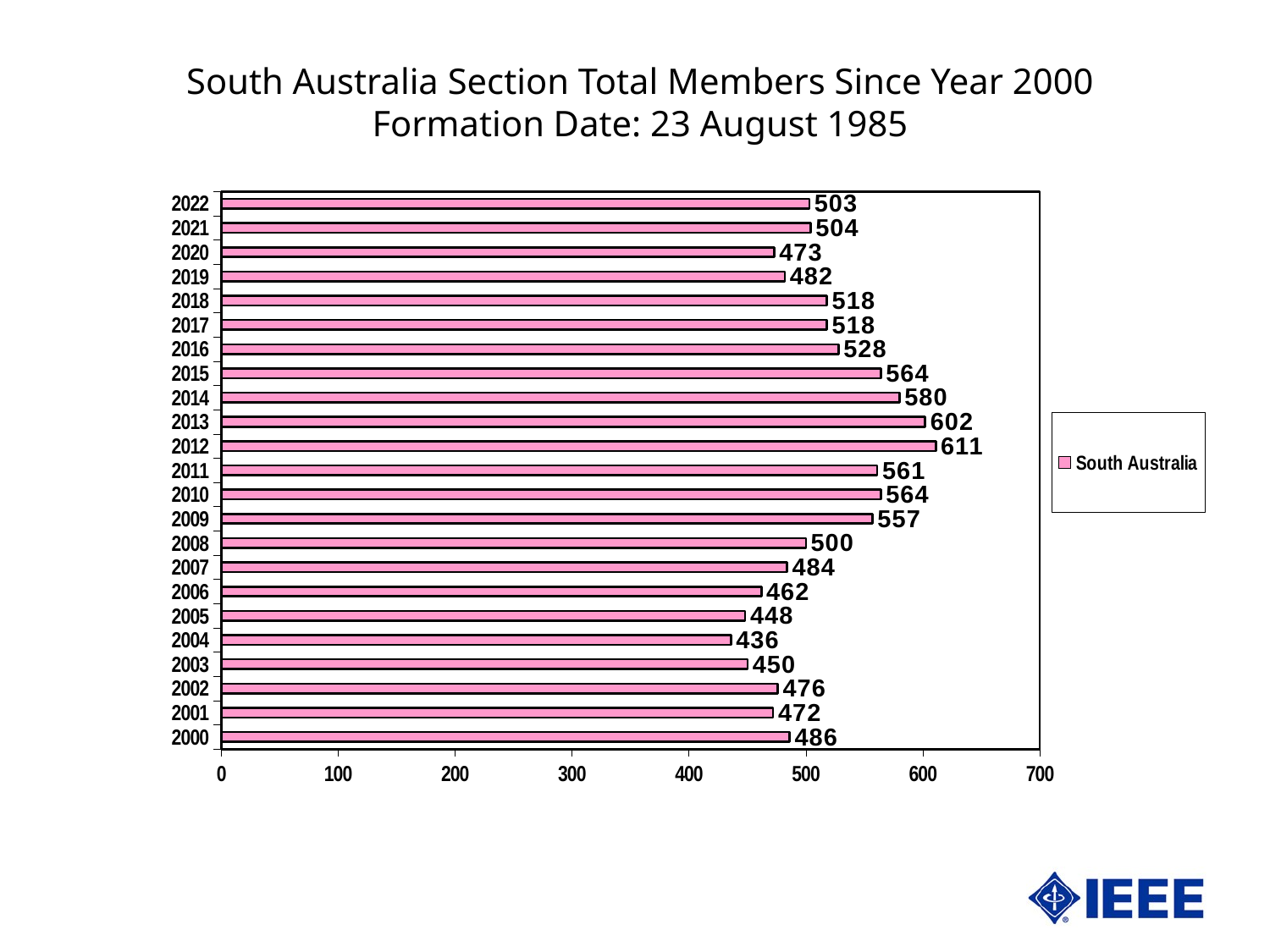
What is the difference in members between 2012 and 2004? 175 Which year had the lowest number of members? 2004 What is the name of the series shown in the legend? South Australia How many series does the legend list? 1 How many years are shown on the chart? 23 What was the total number of members in 2022? 503 What kind of chart is shown on the slide? Bar chart Which year had the highest number of members? 2012 Is the value for 2013 greater or less than 600? greater What was the total number of members in 2004? 436 What was the total number of South Australia Section members in 2012? 611 Which year had more members, 2014 or 2016? 2014